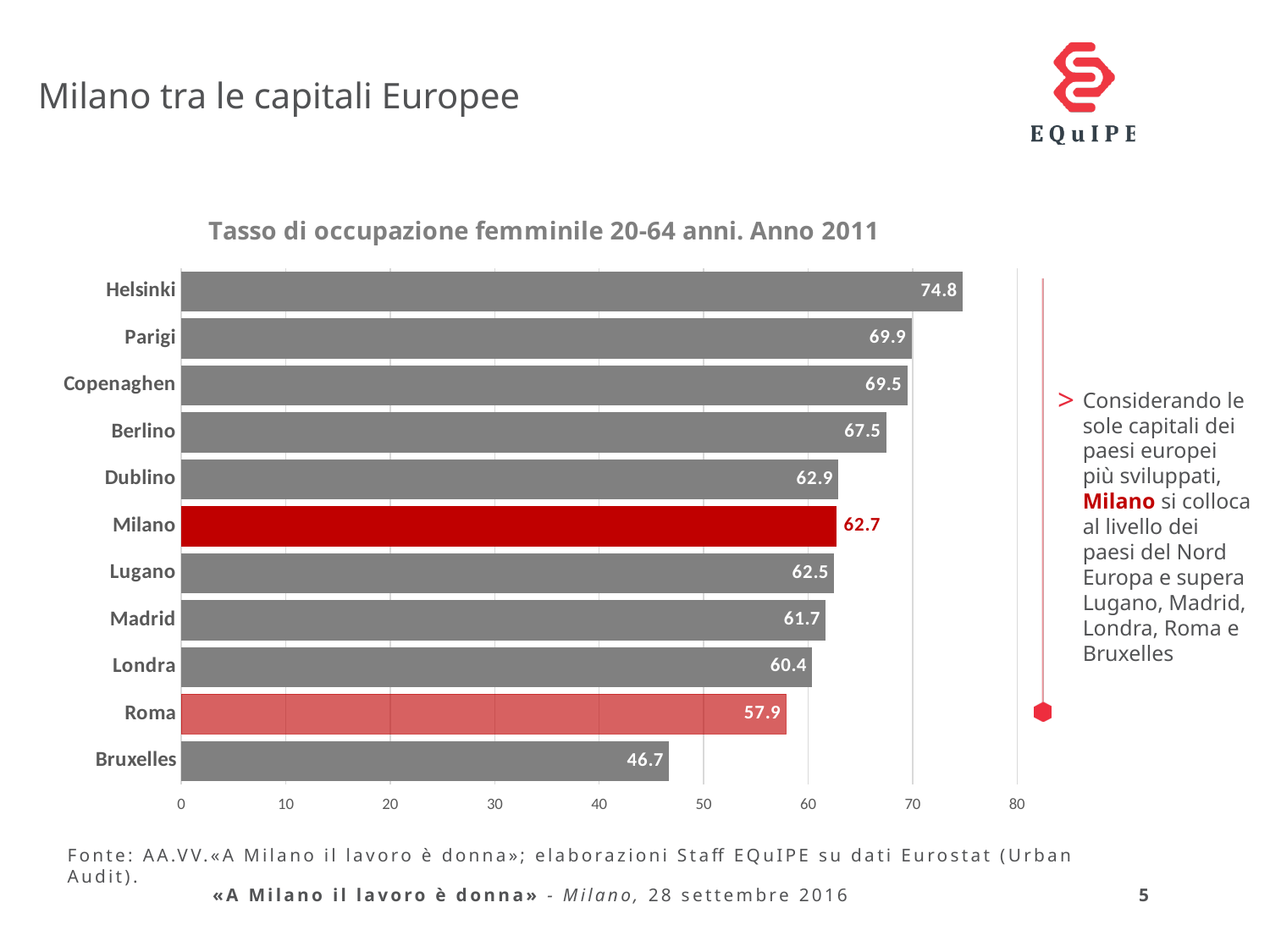
How many cities are shown in the chart? 11 Which city has the highest value? Helsinki Is the value for Roma greater or less than 60? less What is the difference between the values for Helsinki and Milano? 12.1 What is the value for Milano? 62.7 What is the value for Bruxelles? 46.7 Which city has the lowest value? Bruxelles What is the value for Londra? 60.4 What kind of chart is shown on the slide? bar chart What is the title of the chart? Tasso di occupazione femminile 20-64 anni. Anno 2011 What is the difference between the values for Milano and Roma? 4.8 Which has a larger value, Berlino or Dublino? Berlino